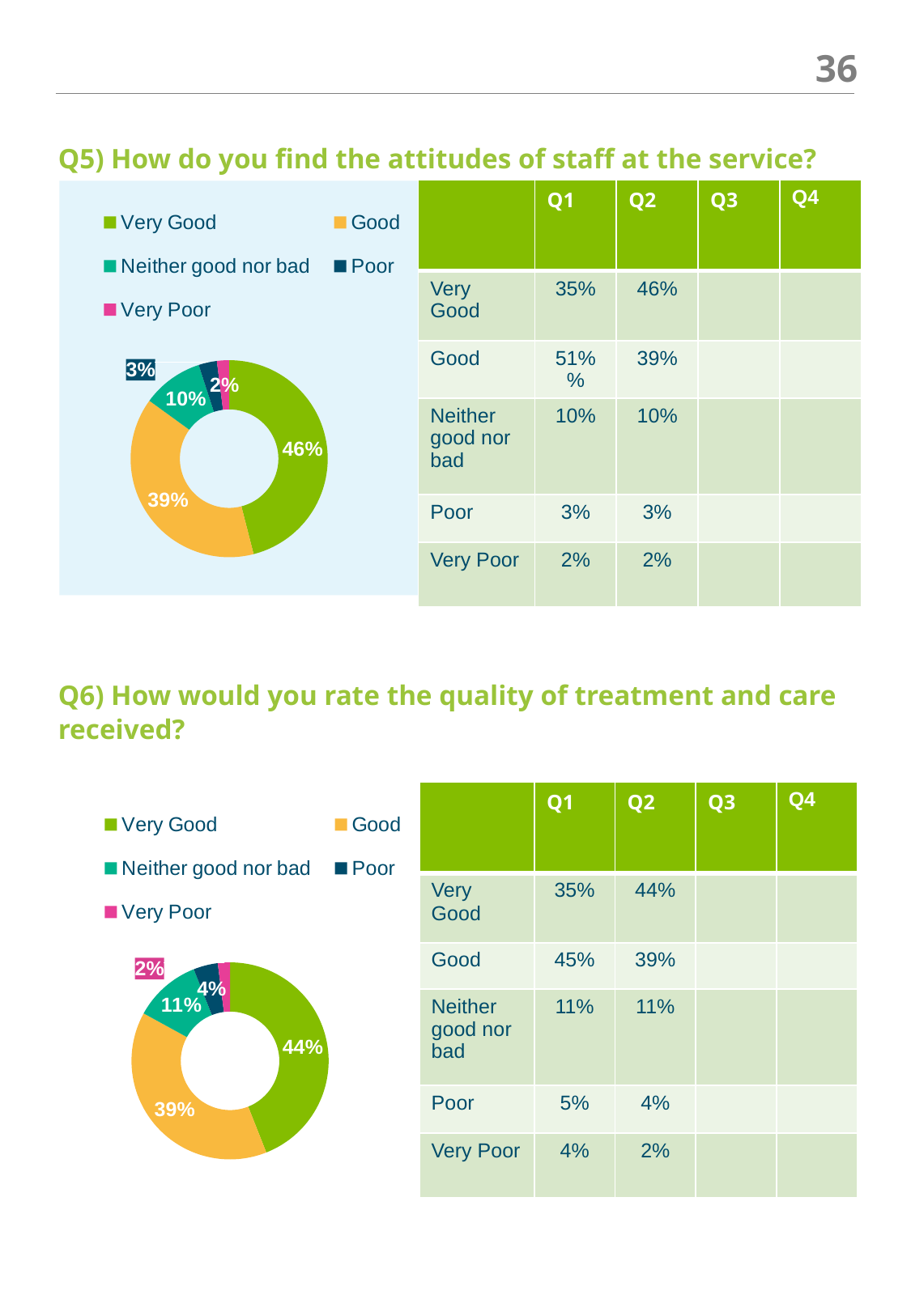
What type of chart is used for Q6 (quality of treatment and care)? doughnut chart In the Q5 chart (attitudes of staff), what is the difference between the Very Good and Good shares? 7% In the Q5 chart (attitudes of staff), which category has the smallest slice? Very Poor In the Q5 chart (attitudes of staff), how many categories does the legend list? 5 In the Q5 chart (attitudes of staff), what share is labelled for Very Good? 46% In the Q5 chart (attitudes of staff), what colour represents Very Poor in the legend? pink In the Q5 chart (attitudes of staff), what share is labelled for Good? 39% In the Q6 chart (quality of treatment and care), what is the combined share of Very Good and Good? 83% In the Q6 chart (quality of treatment and care), what share is labelled for Neither good nor bad? 11% In the Q6 chart (quality of treatment and care), what share is labelled for Very Good? 44% In the Q5 chart (attitudes of staff), which category has the largest slice? Very Good In the Q6 chart (quality of treatment and care), which is larger, the Poor slice or the Very Poor slice? Poor